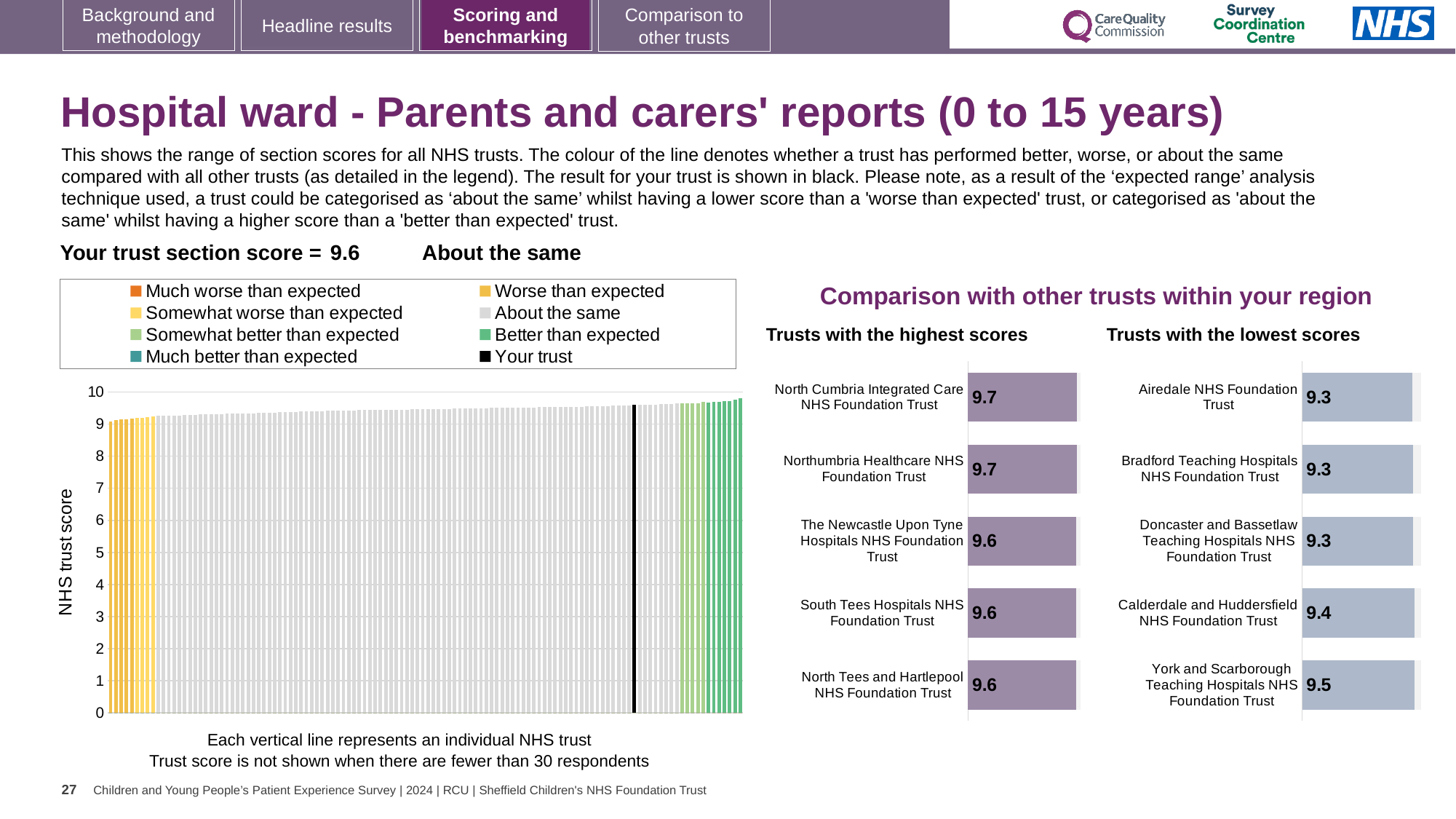
In the 'Trusts with the highest scores' chart, what is the score for North Cumbria Integrated Care NHS Foundation Trust? 9.7 In the 'Trusts with the highest scores' chart, what is the difference between the scores of Northumbria Healthcare NHS Foundation Trust and North Tees and Hartlepool NHS Foundation Trust? 0.1 In the 'Trusts with the lowest scores' chart, what is the score for Calderdale and Huddersfield NHS Foundation Trust? 9.4 In the 'Trusts with the lowest scores' chart, what is the difference between the scores of York and Scarborough Teaching Hospitals NHS Foundation Trust and Airedale NHS Foundation Trust? 0.2 In the chart on the left, how many entries does the legend list? 8 In the 'Trusts with the highest scores' chart, how many trusts are shown? 5 In the 'Trusts with the lowest scores' chart, which trust has the highest score? York and Scarborough Teaching Hospitals NHS Foundation Trust In the chart on the left, is the value for the black 'Your trust' bar greater or less than 9? greater In the chart on the left, what colour denotes 'Your trust' in the legend? black In the 'Trusts with the highest scores' chart, what is the score for The Newcastle Upon Tyne Hospitals NHS Foundation Trust? 9.6 What kind of chart is the chart on the left with the y-axis labelled 'NHS trust score'? bar chart In the 'Trusts with the lowest scores' chart, which has the larger score: York and Scarborough Teaching Hospitals NHS Foundation Trust or Calderdale and Huddersfield NHS Foundation Trust? York and Scarborough Teaching Hospitals NHS Foundation Trust